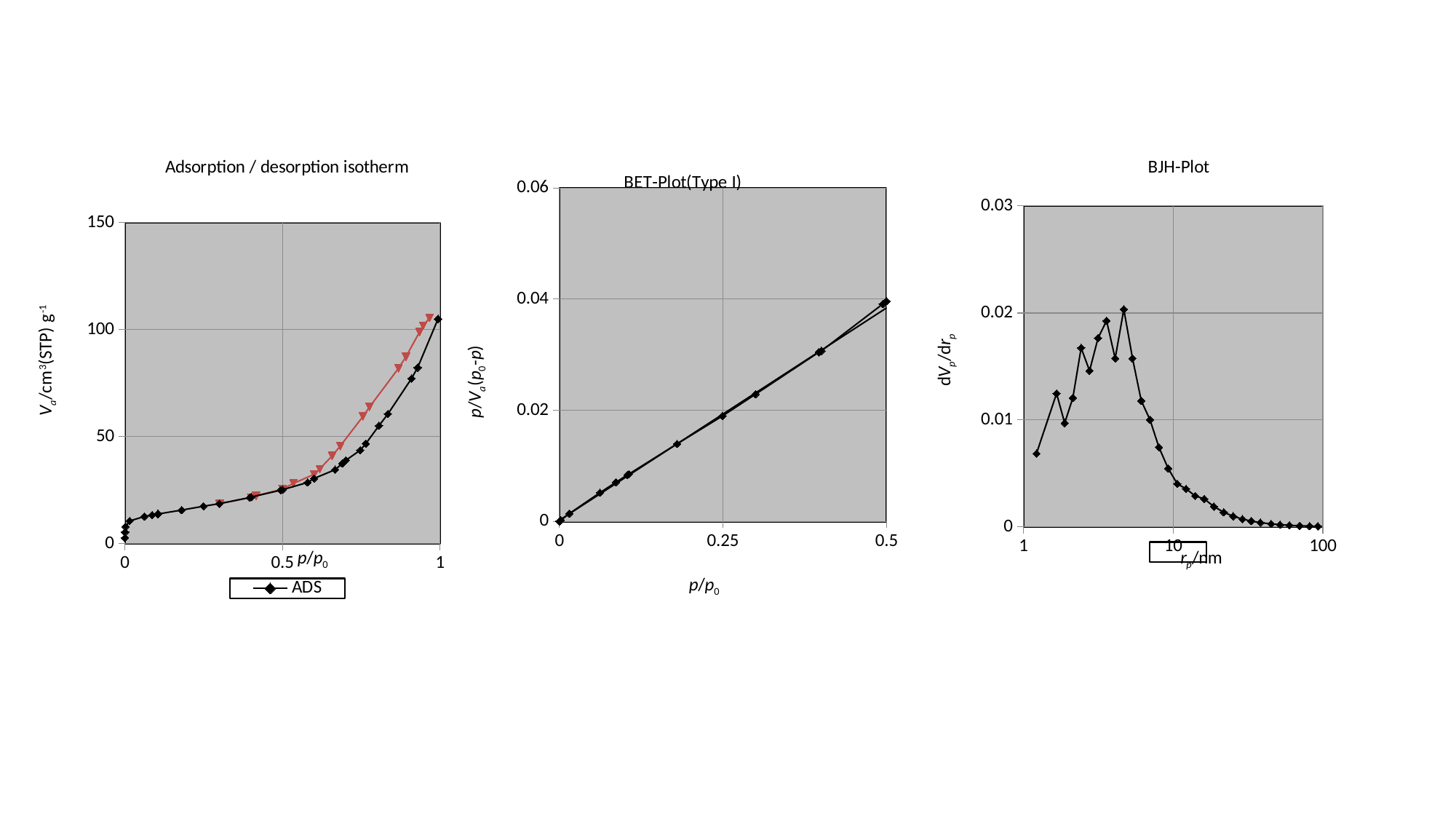
In the 'BJH-Plot' chart, do the values rise or fall as rp increases from 10 nm to 100 nm? fall In the 'Adsorption / desorption isotherm' chart, is the ADS value at p/p0 = 1 greater or less than 50? greater In the 'Adsorption / desorption isotherm' chart, what series name does the legend list? ADS In the 'BET-Plot(Type I)' chart, do the values rise or fall as p/p0 increases from 0 to 0.5? rise How many charts are shown on the slide? 3 In the 'BET-Plot(Type I)' chart, is the value at p/p0 = 0.1 greater or less than 0.02? less In the 'BJH-Plot' chart, is the value at rp = 100 nm greater or less than 0.01? less What kind of chart is the 'Adsorption / desorption isotherm' chart? line chart What is the title of the middle chart on the slide? BET-Plot(Type I) In the 'Adsorption / desorption isotherm' chart, is the ADS value larger at p/p0 = 1 or at p/p0 = 0.5? p/p0 = 1